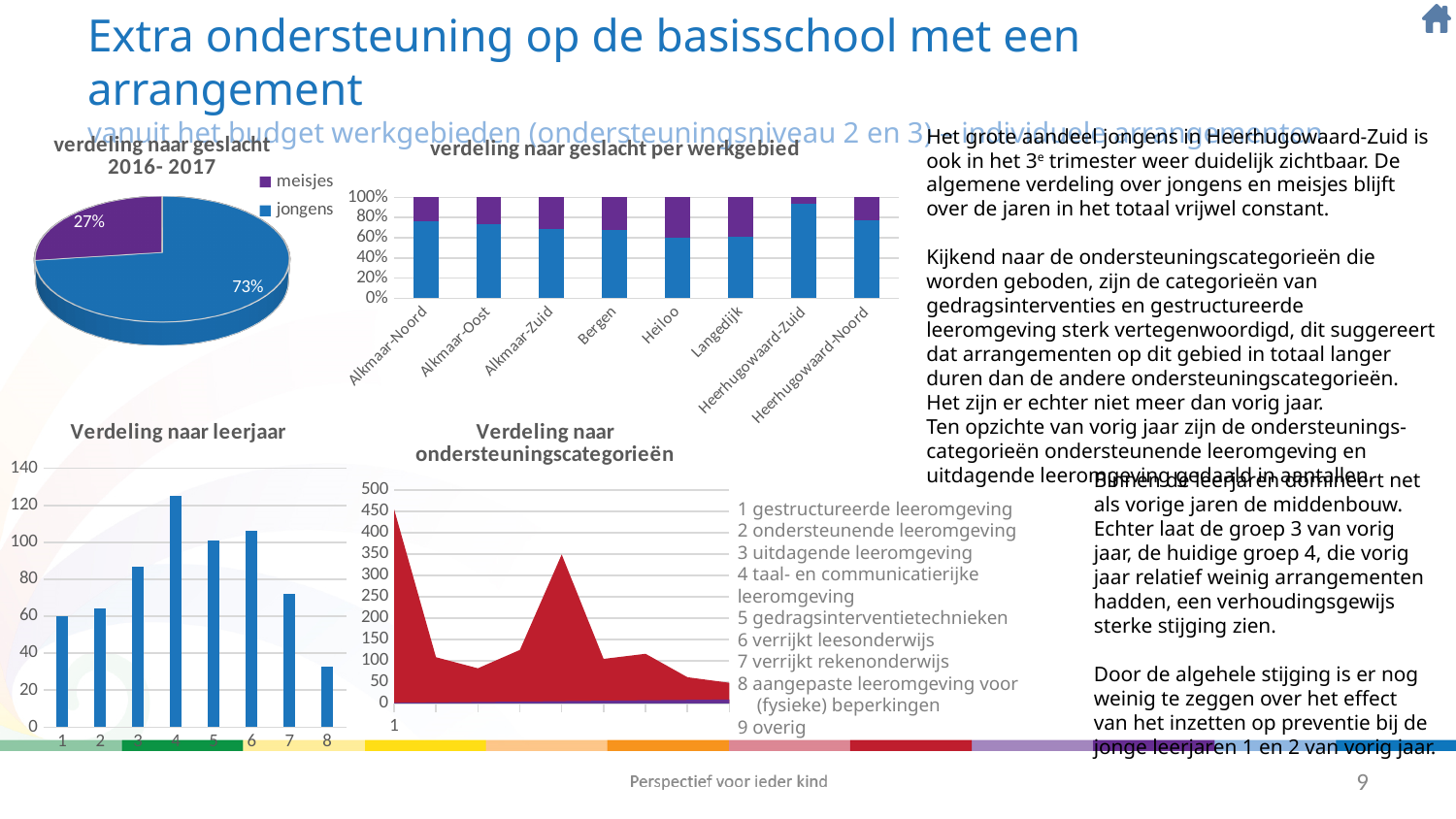
In the pie chart 'verdeling naar geslacht 2016-2017', which group has the larger share? jongens In the chart 'Verdeling naar leerjaar', which leerjaar has the lowest value? 8 In the pie chart 'verdeling naar geslacht 2016-2017', what percentage is shown for meisjes? 27% In the chart 'verdeling naar geslacht per werkgebied', which werkgebied has the highest share of jongens? Heerhugowaard-Zuid In the chart 'verdeling naar geslacht per werkgebied', is the share of jongens for Alkmaar-Zuid greater or less than 80%? less In the chart 'Verdeling naar leerjaar', which leerjaar has the highest value? 4 How many entries does the legend of the chart 'Verdeling naar ondersteuningscategorieën' list? 9 In the chart 'Verdeling naar leerjaar', is the value for leerjaar 4 greater or less than 120? greater How many werkgebieden are shown on the x axis of the chart 'verdeling naar geslacht per werkgebied'? 8 How many entries does the legend of the pie chart 'verdeling naar geslacht 2016-2017' list? 2 What kind of chart is 'verdeling naar geslacht per werkgebied'? stacked bar chart In the pie chart 'verdeling naar geslacht 2016-2017', what percentage is shown for jongens? 73%